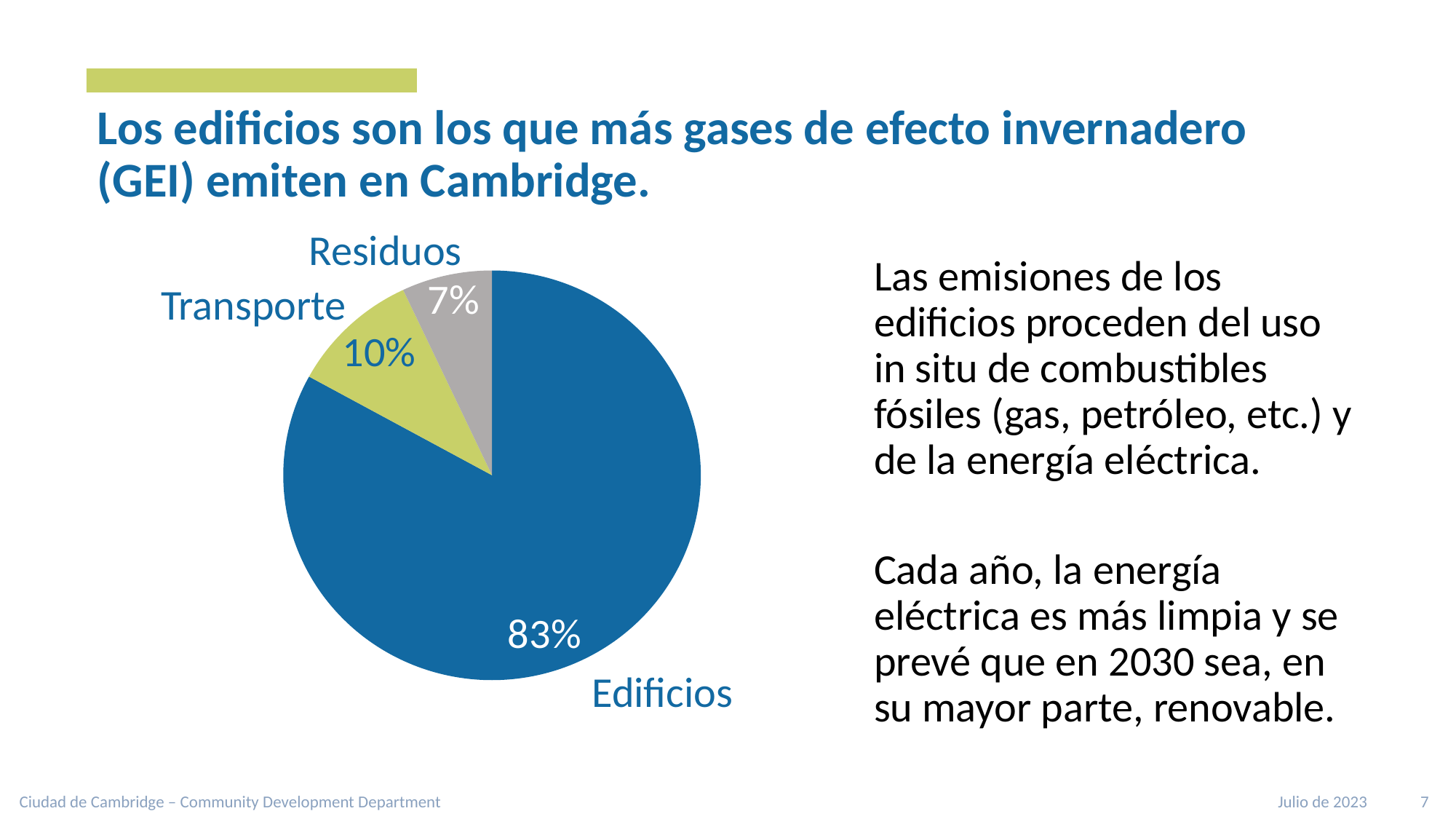
What is the difference in percentage points between Edificios and Transporte? 73 How many categories are shown in the pie chart? 3 What share of the pie does Residuos represent? 7% Which category has the smallest slice of the pie? Residuos Which is larger, the slice for Transporte or the slice for Residuos? Transporte What is the difference in percentage points between Transporte and Residuos? 3 What colour is the Edificios slice? Blue What kind of chart is shown on the slide? Pie chart What share of the pie does Transporte represent? 10% Which category has the largest slice of the pie? Edificios What colour is the Residuos slice? Grey What share of the pie does Edificios represent? 83%